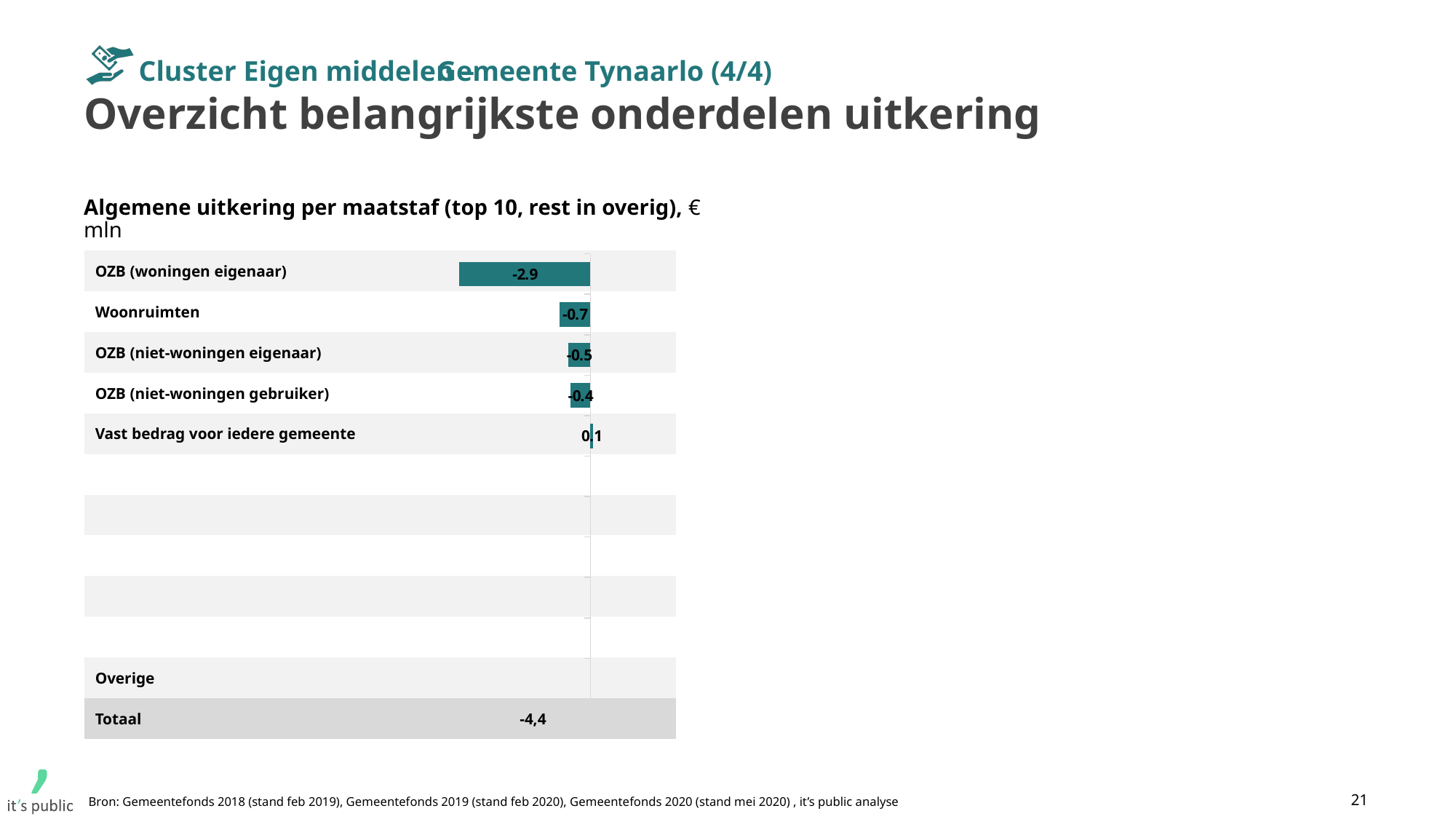
What is the value for Vast bedrag voor iedere gemeente? 0.1 Which has the larger negative value, Woonruimten or OZB (niet-woningen eigenaar)? Woonruimten What is the value shown in the Totaal row? -4,4 What is the difference between the values for OZB (woningen eigenaar) and Woonruimten? 2.2 What is the value for Woonruimten? -0.7 What is the value for OZB (niet-woningen eigenaar)? -0.5 What is the value for OZB (niet-woningen gebruiker)? -0.4 What kind of chart is shown on the slide? Bar chart What is the title of the chart? Algemene uitkering per maatstaf (top 10, rest in overig), € mln Which category has the lowest (most negative) value? OZB (woningen eigenaar) Which category has the highest value? Vast bedrag voor iedere gemeente What is the value for OZB (woningen eigenaar)? -2.9